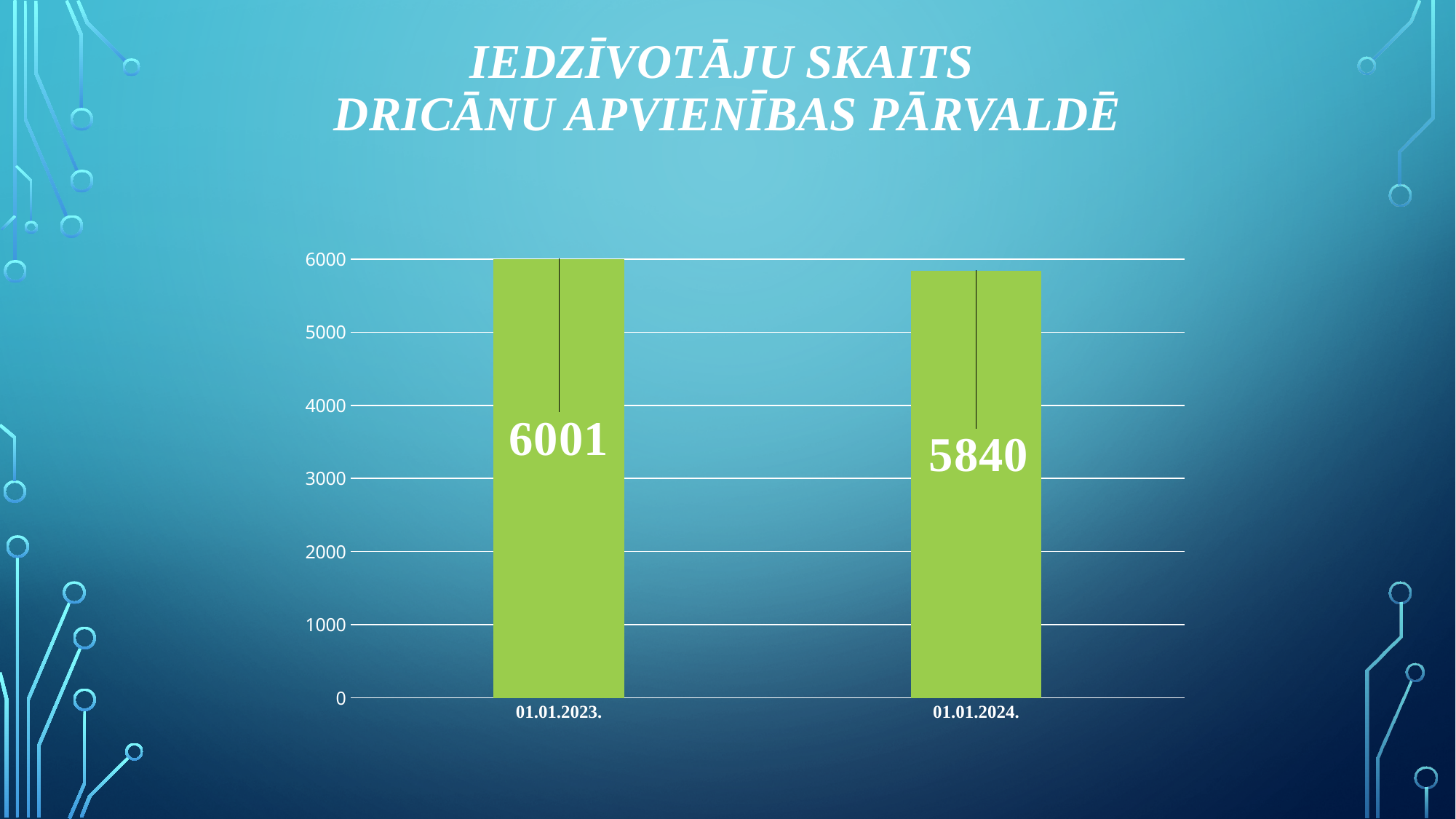
Which is larger, the value for 01.01.2023. or the value for 01.01.2024.? 01.01.2023. What is the difference between the values for 01.01.2023. and 01.01.2024.? 161 What is the value for 01.01.2024.? 5840 How many categories are shown on the chart? 2 What is the title of the slide? Iedzīvotāju skaits Dricānu apvienības pārvaldē What colour are the bars on the chart? green What kind of chart is shown on the slide? bar chart Which category has the lowest value? 01.01.2024. Is the value for 01.01.2024. greater or less than 5000? greater Which category has the highest value? 01.01.2023. What is the value for 01.01.2023.? 6001 Do the values rise or fall from 01.01.2023. to 01.01.2024.? fall